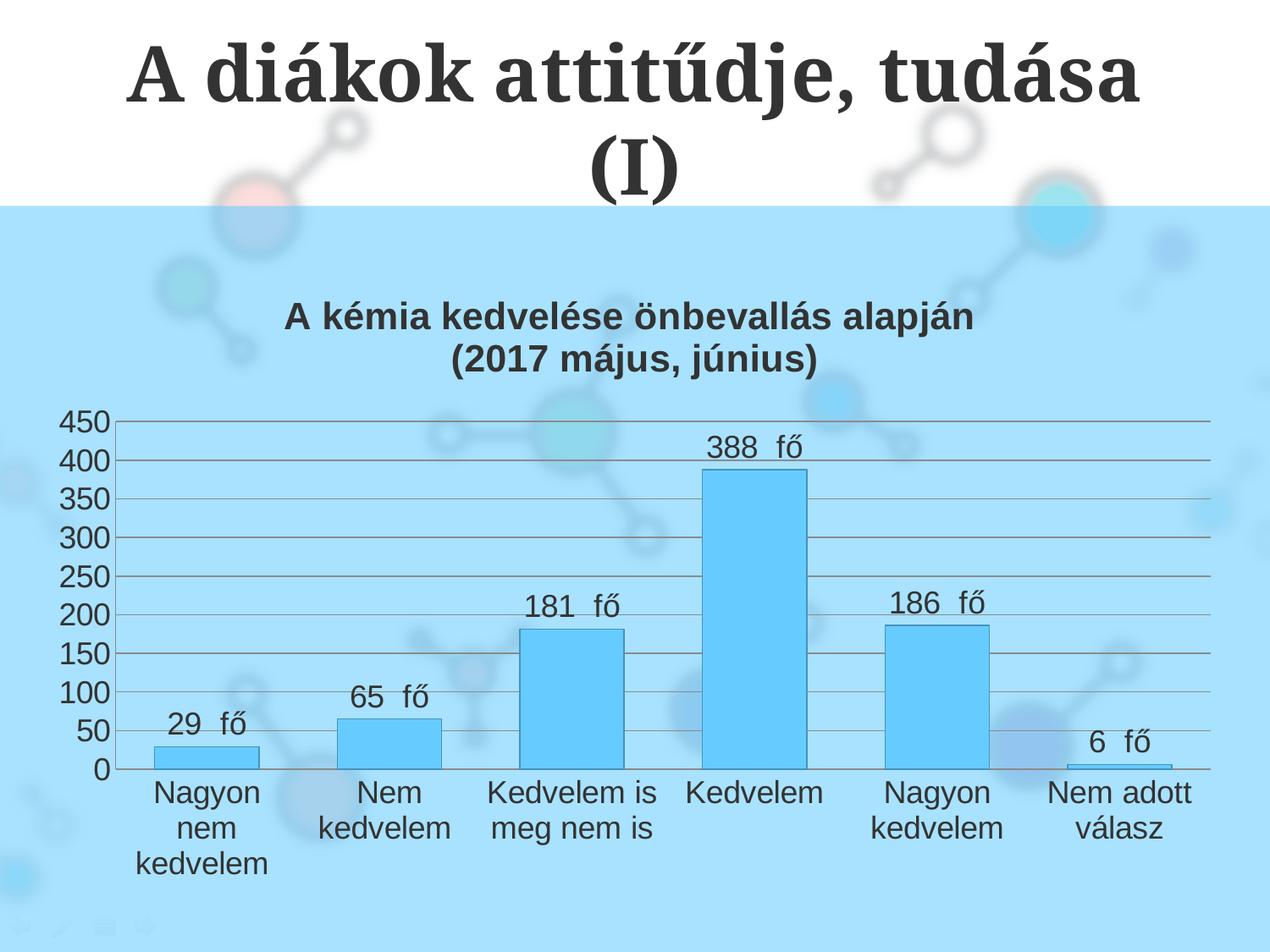
What is the value for "Nagyon nem kedvelem"? 29 fő What is the difference between the values for "Kedvelem" and "Nagyon kedvelem"? 202 fő Which category has the highest value? Kedvelem What is the value for "Kedvelem"? 388 fő Which is larger, the value for "Nagyon kedvelem" or the value for "Kedvelem is meg nem is"? Nagyon kedvelem What is the title of the chart? A kémia kedvelése önbevallás alapján (2017 május, június) Which category has the lowest value? Nem adott válasz How many categories are shown on the x axis? 6 What kind of chart is shown on the slide? bar chart Is the value for "Kedvelem" greater or less than 350? greater What is the value for "Nem adott válasz"? 6 fő What is the difference between the values for "Nem kedvelem" and "Nagyon nem kedvelem"? 36 fő